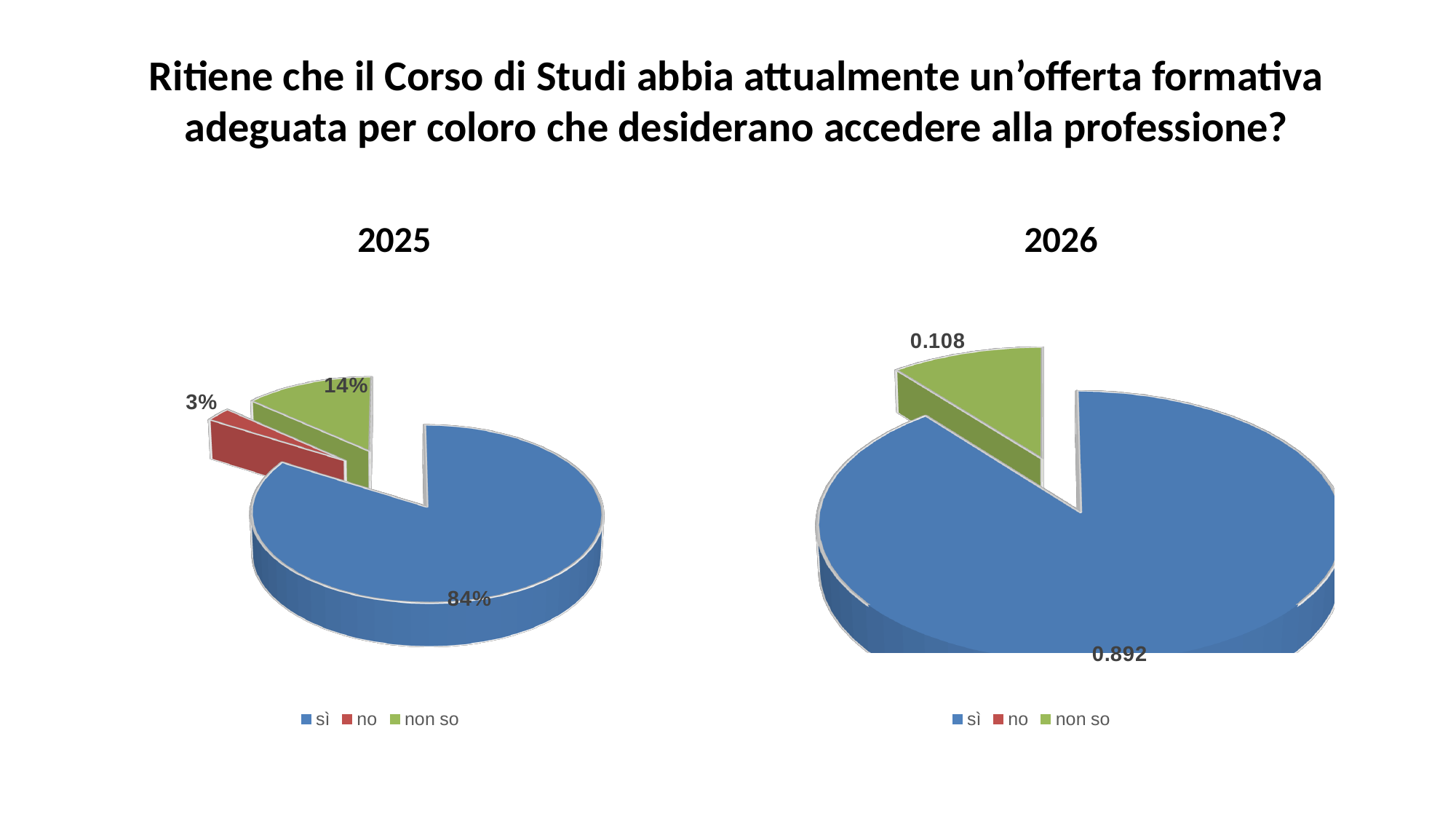
How many entries does the legend of the 2025 chart list? 3 In the 2025 chart, what is the difference between the values for "non so" and "no"? 11% In the 2026 chart, what colour is the "non so" slice? green In the 2026 chart, which is larger, "sì" or "non so"? sì In the 2025 chart, which category has the smallest slice? no In the 2025 chart, what is the value for "non so"? 14% In the 2026 chart, what is the value for "sì"? 0.892 What kind of chart is the 2026 chart? pie chart In the 2026 chart, what is the value for "non so"? 0.108 In the 2025 chart, what is the value for "sì"? 84% In the 2025 chart, which category has the largest slice? sì In the 2025 chart, what is the value for "no"? 3%